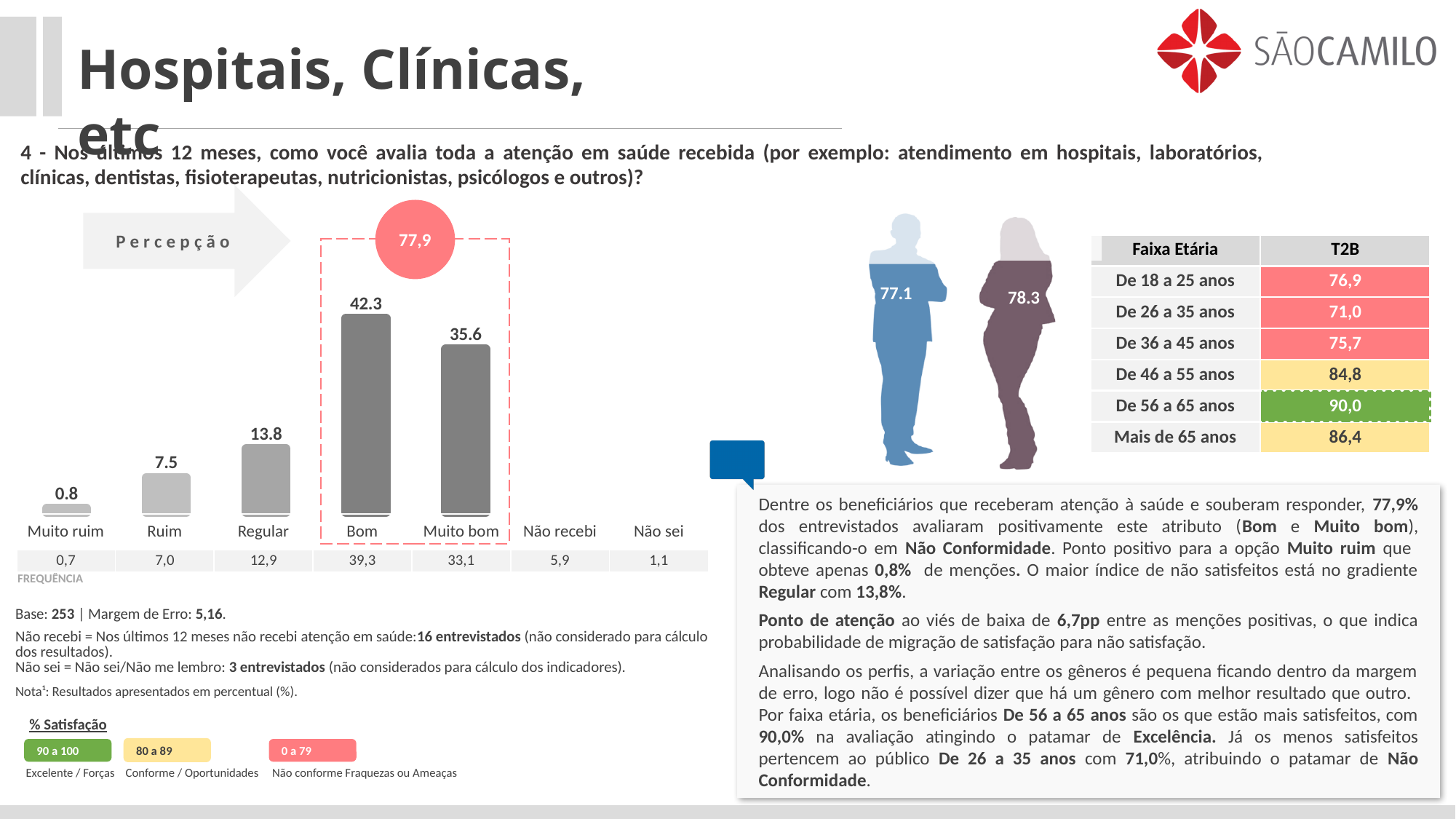
How many bars are plotted in the bar chart? 5 Which category has the highest bar in the bar chart? Bom In the bar chart, what is the difference between the values for 'Regular' and 'Ruim'? 6.3 What type of chart is used to show the evaluation of health care received (Muito ruim to Muito bom)? bar chart In the bar chart, what is the value for 'Bom'? 42.3 In the bar chart, what is the difference between the values for 'Bom' and 'Muito bom'? 6.7 In the bar chart, what is the value for 'Muito ruim'? 0.8 In the bar chart, which is larger: the value for 'Ruim' or the value for 'Regular'? Regular In the bar chart, what is the combined value of 'Bom' and 'Muito bom' shown in the circle above the dashed box? 77,9 Which category has the lowest bar in the bar chart? Muito ruim In the bar chart, what is the value for 'Muito bom'? 35.6 In the bar chart, what is the value for 'Regular'? 13.8